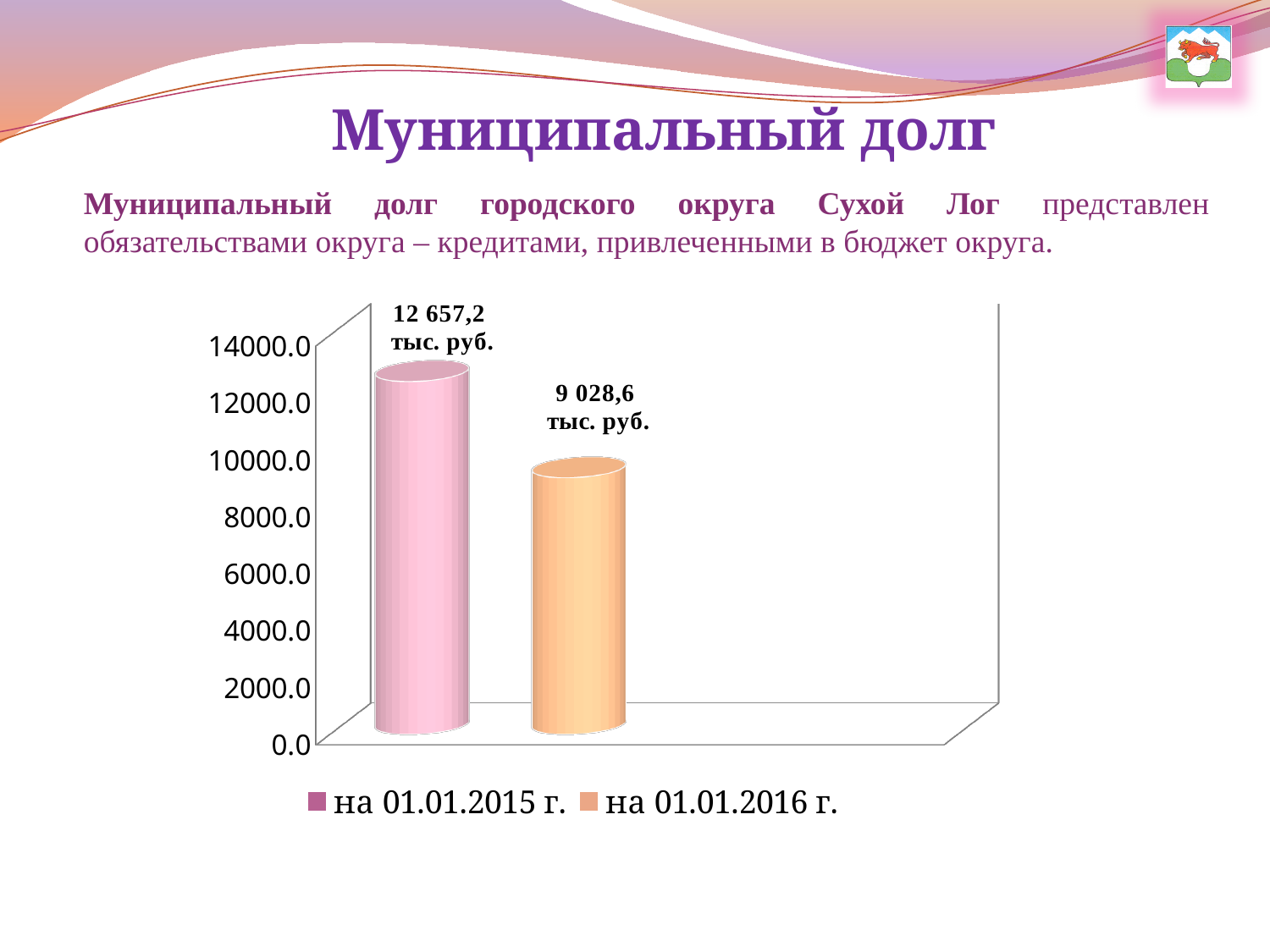
How many series does the legend list? 2 How many bars are plotted on the chart? 2 What is the title of the slide containing the chart? Муниципальный долг Which series has the lowest value on the chart? на 01.01.2016 г. Which series has the higher value, на 01.01.2015 г. or на 01.01.2016 г.? на 01.01.2015 г. Is the value for на 01.01.2016 г. greater or less than 10000.0? less What is the municipal debt value shown for на 01.01.2015 г.? 12 657,2 тыс. руб. Is the value for на 01.01.2015 г. greater or less than 12000.0? greater What is the municipal debt value shown for на 01.01.2016 г.? 9 028,6 тыс. руб. What kind of chart is shown on the slide? bar chart What is the difference between the values for на 01.01.2015 г. and на 01.01.2016 г.? 3 628,6 тыс. руб. Is the value for на 01.01.2016 г. larger or smaller than the value for на 01.01.2015 г.? smaller